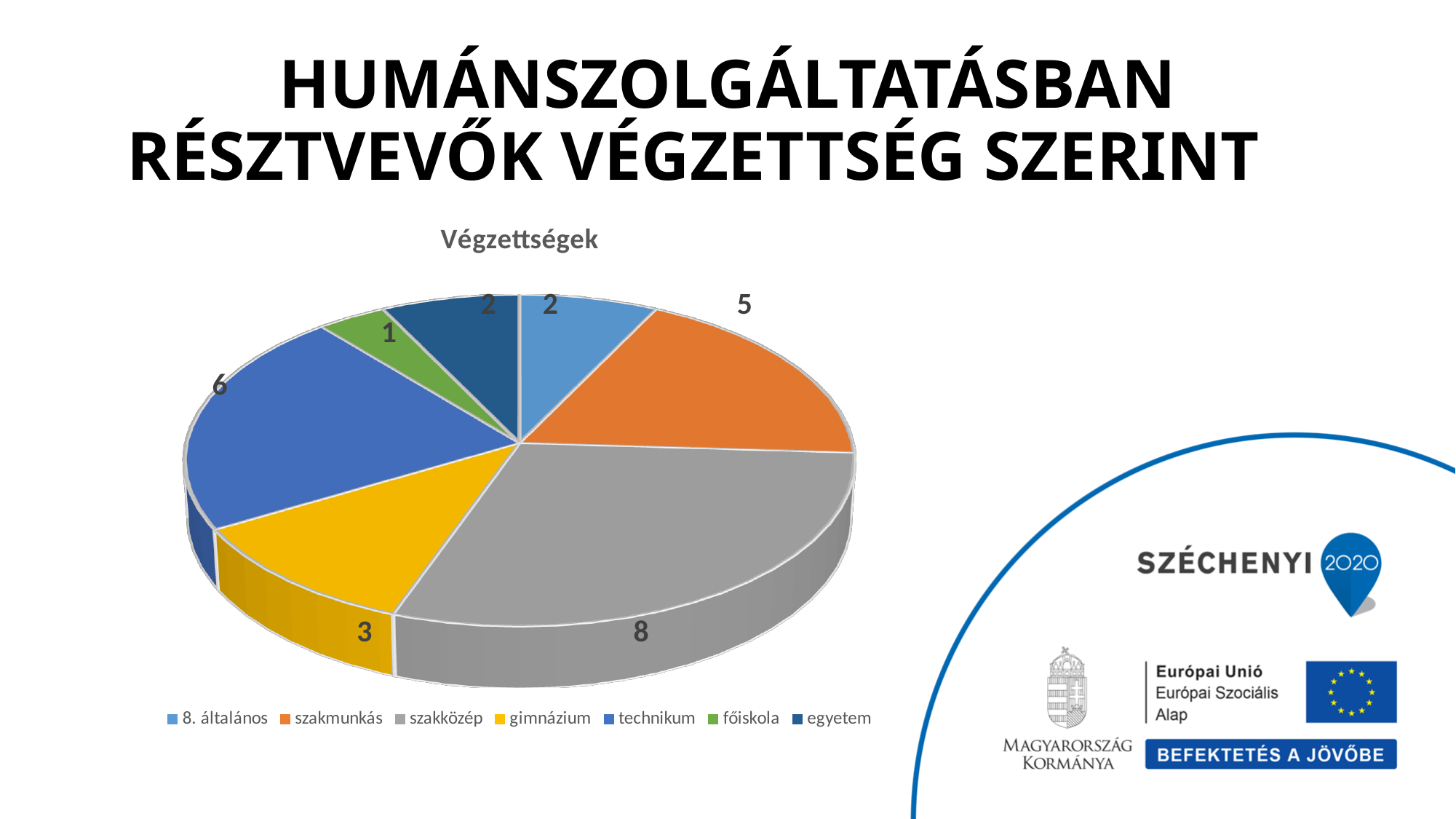
What is the value for gimnázium? 3 What is the title of the chart? Végzettségek What kind of chart is shown on the slide? pie chart What is the difference between the values for szakközép and technikum? 2 What is the total of all the slices in the pie chart? 27 What is the value for szakközép? 8 Which category has the smallest slice? főiskola How many categories does the pie chart have? 7 Which category has the largest slice? szakközép What is the value for szakmunkás? 5 Which is larger, the value for szakmunkás or the value for gimnázium? szakmunkás What is the value for technikum? 6